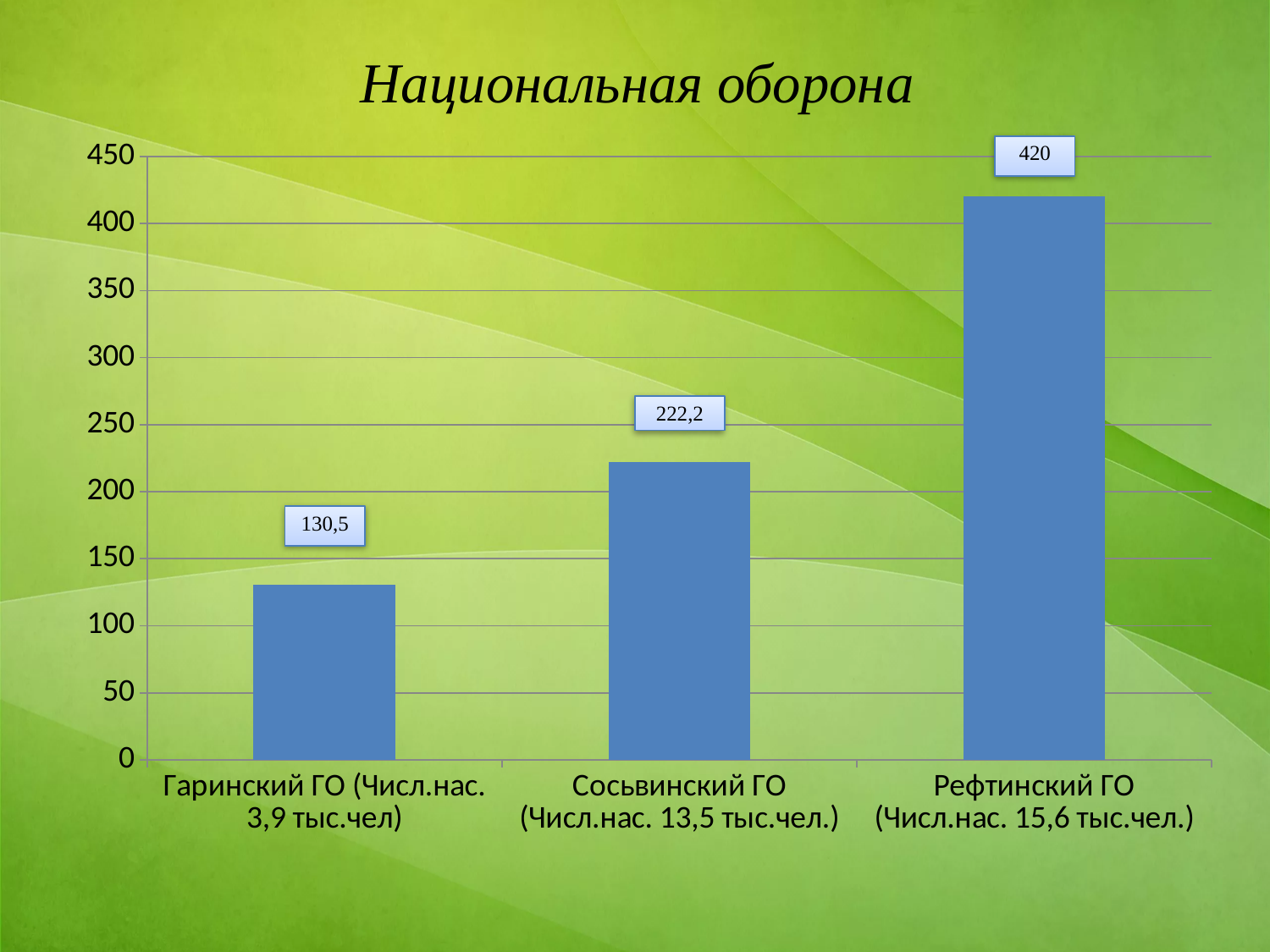
Which category has the highest value? Рефтинский ГО What is the difference between the values for Сосьвинский ГО and Гаринский ГО? 91,7 What kind of chart is shown on the slide? bar chart What is the title of the chart? Национальная оборона Which category has the lowest value? Гаринский ГО What is the value for Сосьвинский ГО? 222,2 How many categories are shown in the chart? 3 What is the difference between the values for Рефтинский ГО and Сосьвинский ГО? 197,8 What is the value for Рефтинский ГО? 420 What is the value for Гаринский ГО? 130,5 Which is larger, the value for Сосьвинский ГО or the value for Гаринский ГО? Сосьвинский ГО Is the value for Рефтинский ГО greater or less than 400? greater